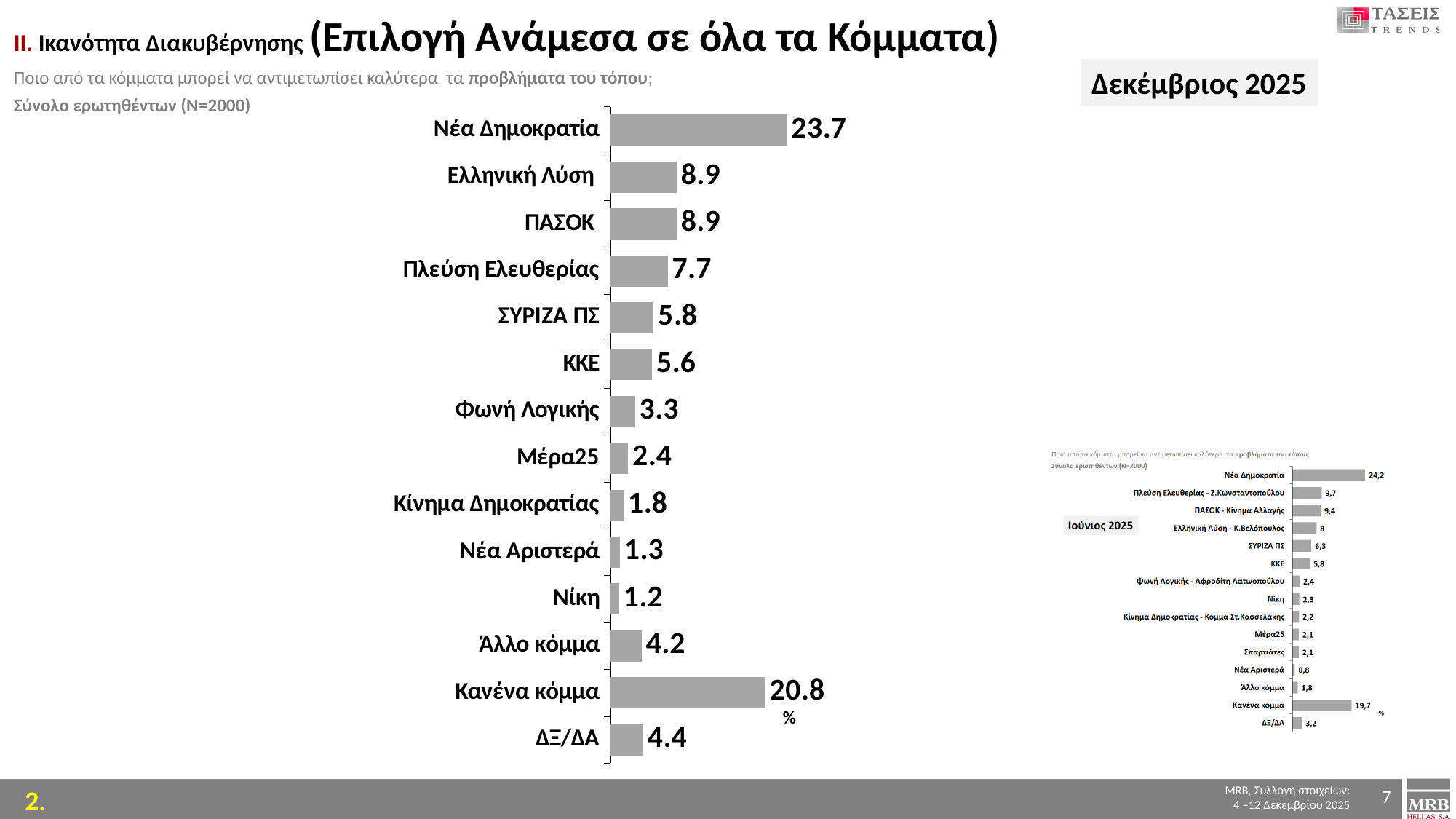
What kind of chart is the large Δεκέμβριος 2025 chart? Bar chart In the small Ιούνιος 2025 inset chart, which category has the lowest value? Νέα Αριστερά How many categories are shown in the large Δεκέμβριος 2025 chart? 14 In the large Δεκέμβριος 2025 chart, what is the value for Νέα Δημοκρατία? 23.7 In the large Δεκέμβριος 2025 chart, what is the value for Κανένα κόμμα? 20.8 In the large Δεκέμβριος 2025 chart, which is larger, Πλεύση Ελευθερίας or ΣΥΡΙΖΑ ΠΣ? Πλεύση Ελευθερίας In the large Δεκέμβριος 2025 chart, which category has the highest value? Νέα Δημοκρατία In the large Δεκέμβριος 2025 chart, what is the value for ΚΚΕ? 5.6 In the small Ιούνιος 2025 inset chart, what is the value for Κανένα κόμμα? 19,7 In the small Ιούνιος 2025 inset chart, what is the value for Νέα Δημοκρατία? 24,2 In the large Δεκέμβριος 2025 chart, what is the difference between Νέα Δημοκρατία and Κανένα κόμμα? 2.9 In the large Δεκέμβριος 2025 chart, which category has the lowest value? Νίκη